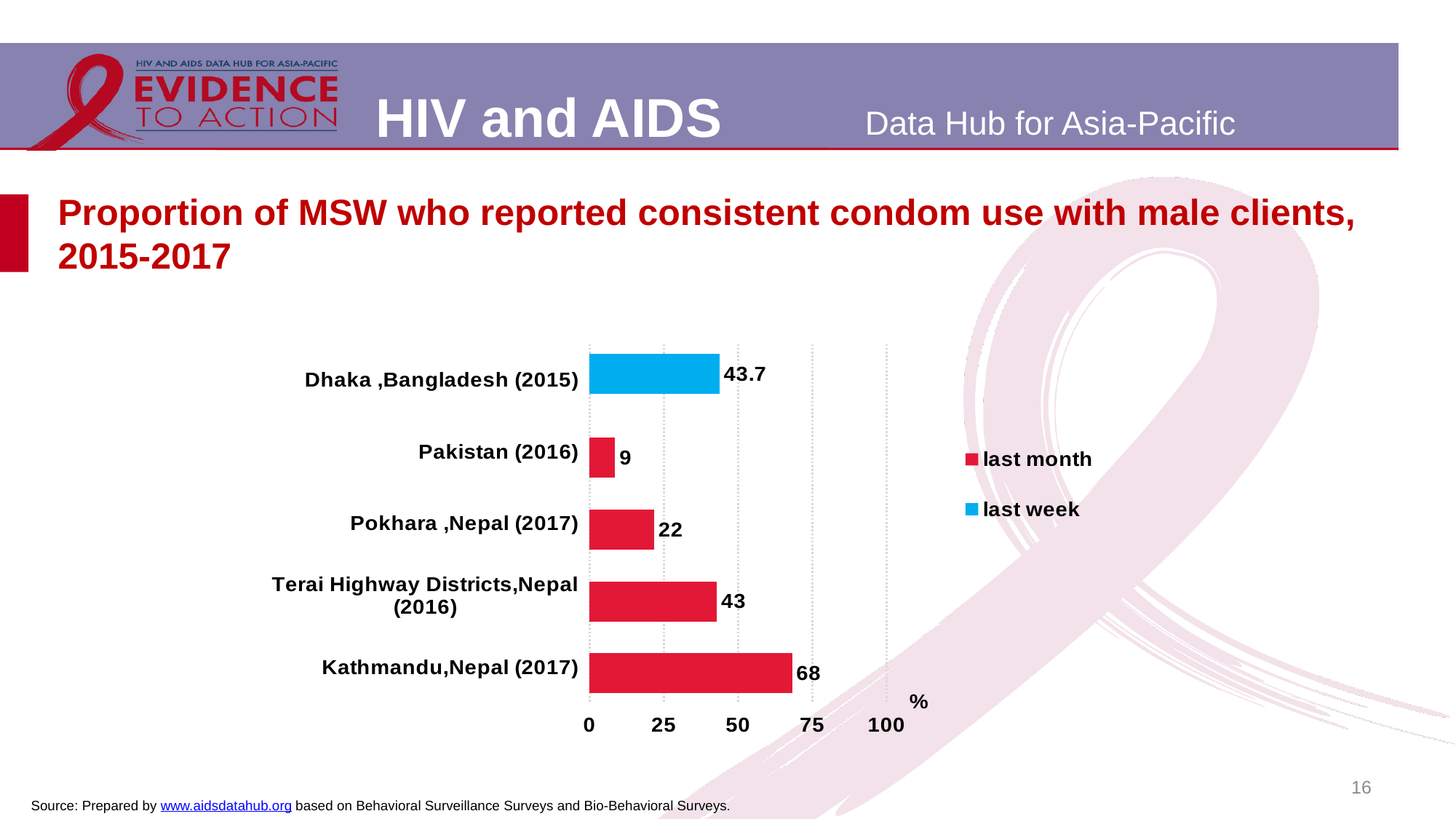
What is the value for Dhaka ,Bangladesh (2015)? 43.7 Which category has the highest value? Kathmandu,Nepal (2017) Which category has the lowest value? Pakistan (2016) What is the value for Terai Highway Districts,Nepal (2016)? 43 How many series does the legend list? 2 What is the difference between the values for Kathmandu,Nepal (2017) and Pokhara ,Nepal (2017)? 46 Which is larger, the value for Pokhara ,Nepal (2017) or the value for Terai Highway Districts,Nepal (2016)? Terai Highway Districts,Nepal (2016) What is the value for Kathmandu,Nepal (2017)? 68 What kind of chart is shown on the slide? bar chart How many categories are shown in the chart? 5 What is the value for Pakistan (2016)? 9 Is the value for Kathmandu,Nepal (2017) greater or less than 50? greater